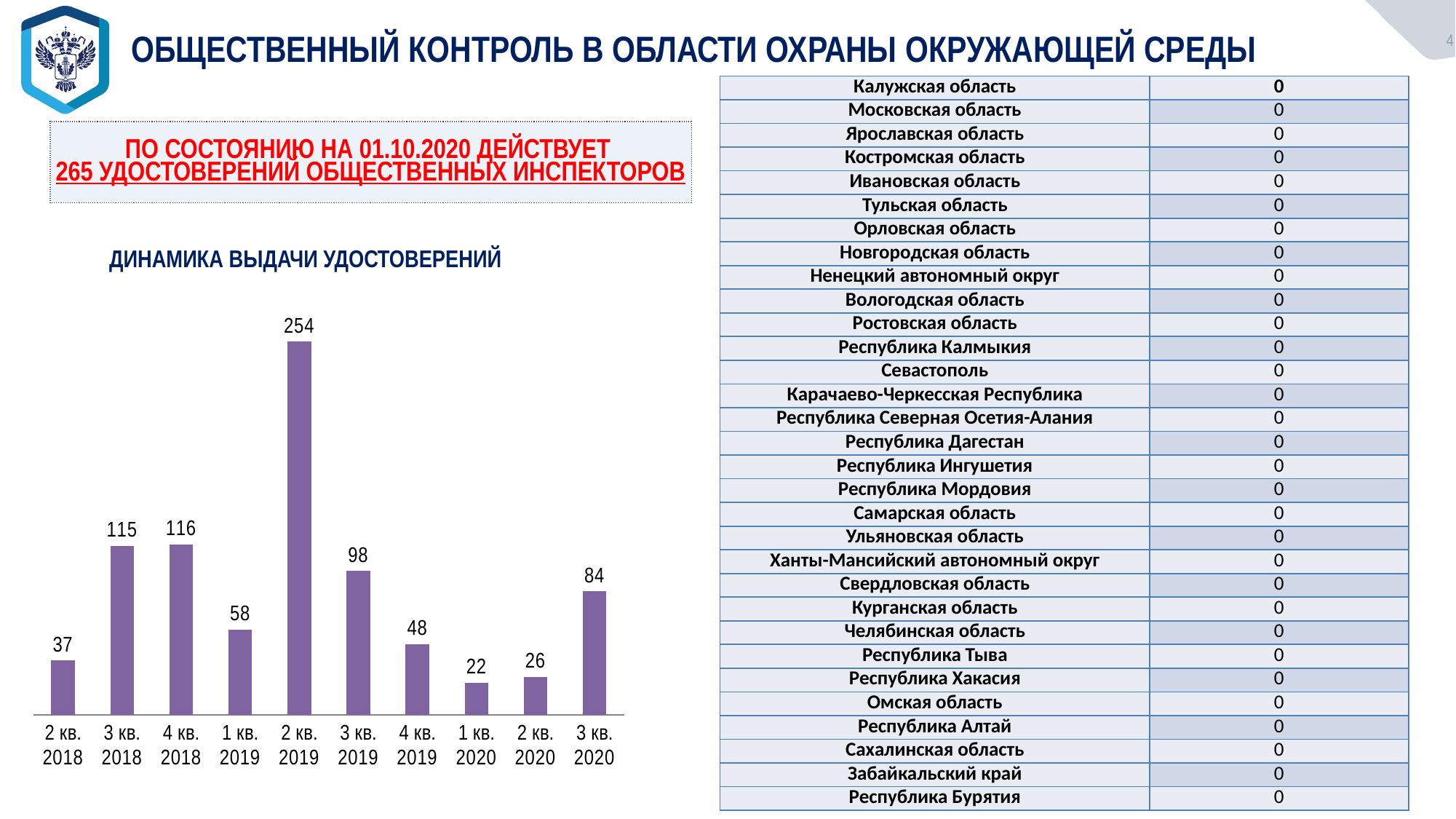
How many quarters (bars) are shown in the chart? 10 Which quarter has the highest value in the chart? 2 кв. 2019 What is the title of the bar chart on the slide? ДИНАМИКА ВЫДАЧИ УДОСТОВЕРЕНИЙ What is the difference between the values for 2 кв. 2019 and 3 кв. 2019? 156 What kind of chart is ДИНАМИКА ВЫДАЧИ УДОСТОВЕРЕНИЙ? bar chart Which quarter has the lowest value in the chart? 1 кв. 2020 What value is shown for 1 кв. 2019 in the chart? 58 Do the values rise or fall from 2 кв. 2019 to 1 кв. 2020? fall What is the difference between the values for 3 кв. 2020 and 2 кв. 2020? 58 What value is shown for 3 кв. 2020 in the chart? 84 What value is shown for 2 кв. 2019 in the chart ДИНАМИКА ВЫДАЧИ УДОСТОВЕРЕНИЙ? 254 Which is larger, the value for 4 кв. 2019 or the value for 3 кв. 2019? 3 кв. 2019